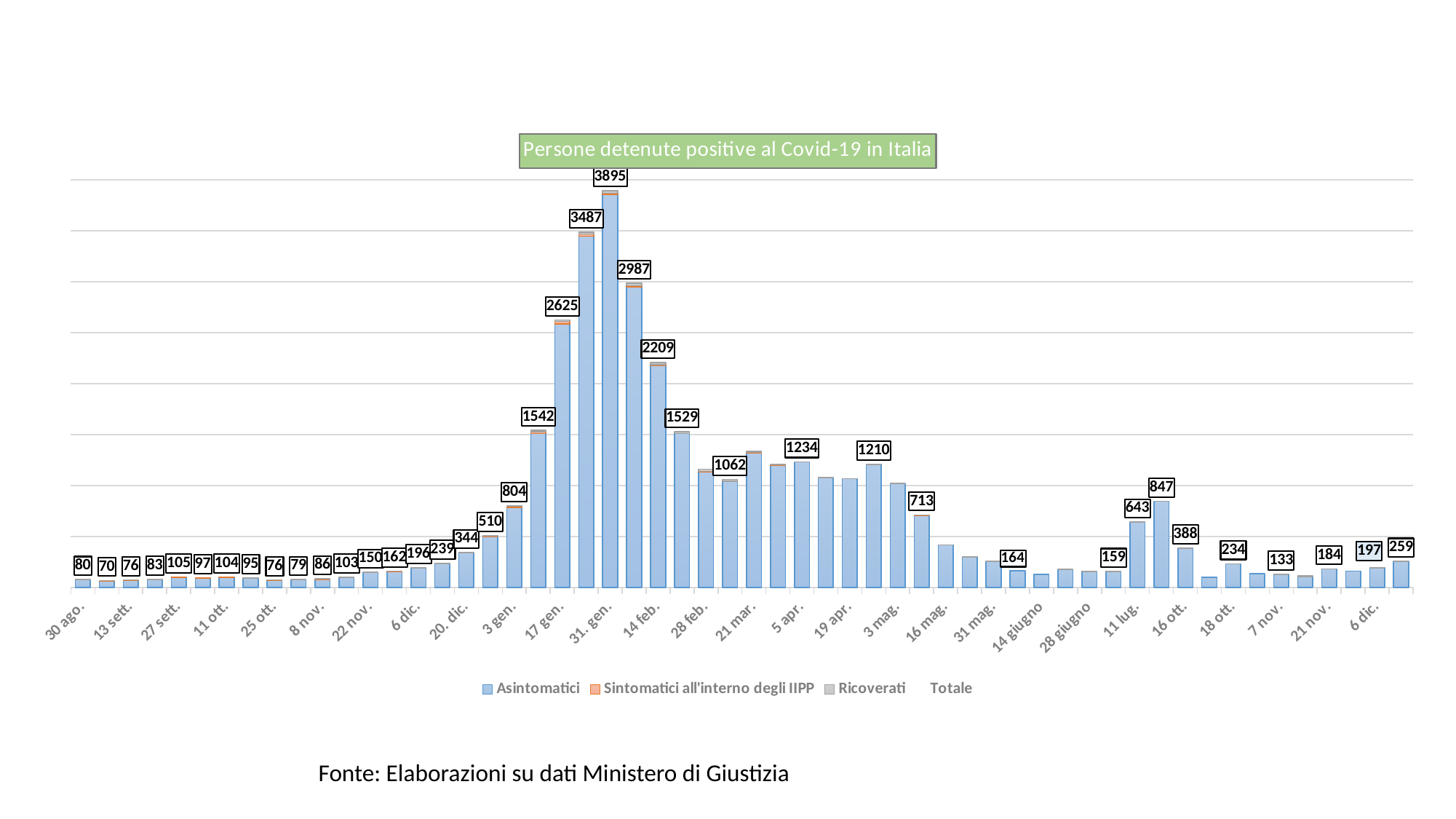
What is the title of the chart? Persone detenute positive al Covid-19 in Italia What is the total value labeled for 3 gen.? 804 What kind of chart is shown on the slide? bar chart What is the lowest total value labeled on the chart? 70 Which is larger, the total for 17 gen. or the total for 14 feb.? 17 gen. What is the total value labeled for 31 gen.? 3895 What is the total value labeled for 16 ott.? 388 How many series does the legend list? 4 What is the total value labeled for 30 ago.? 80 What is the total value labeled for 17 gen.? 2625 Which date has the highest total of positive detainees? 31. gen. What is the difference between the totals for 31 gen. and 17 gen.? 1270